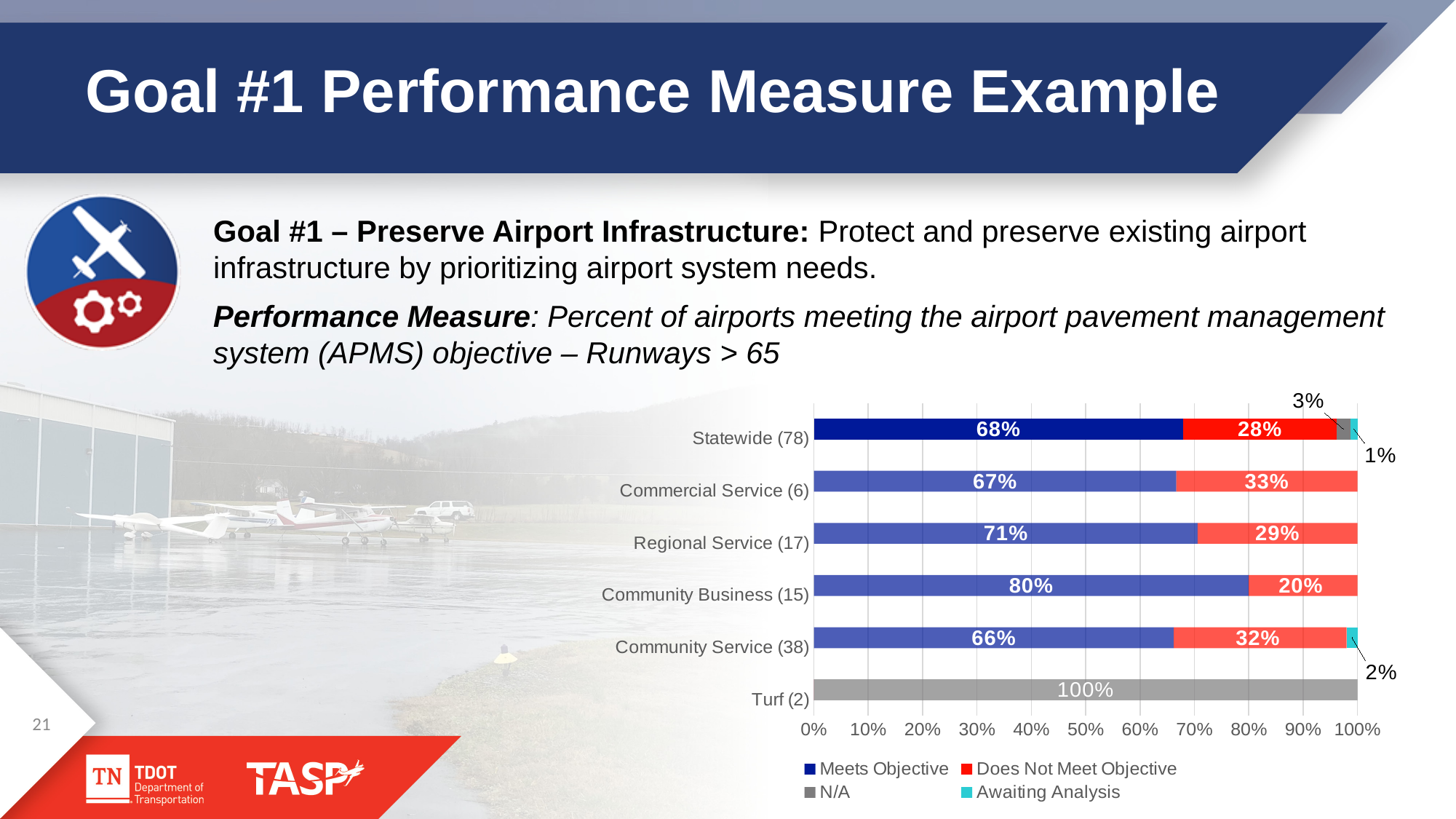
What is the Does Not Meet Objective value for Commercial Service (6)? 33% What is the Meets Objective value for Community Business (15)? 80% What is the N/A value for Turf (2)? 100% How many series does the chart legend list? 4 Which is larger: the Does Not Meet Objective value for Commercial Service (6) or for Regional Service (17)? Commercial Service (6) What percentage of Statewide (78) airports meet the objective? 68% What is the difference between the Meets Objective values for Community Business (15) and Regional Service (17)? 9% What type of chart is shown on the slide? Stacked bar chart Which category has the highest Meets Objective percentage? Community Business (15) How many categories are shown on the chart's vertical axis? 6 What is the Awaiting Analysis value for Community Service (38)? 2%